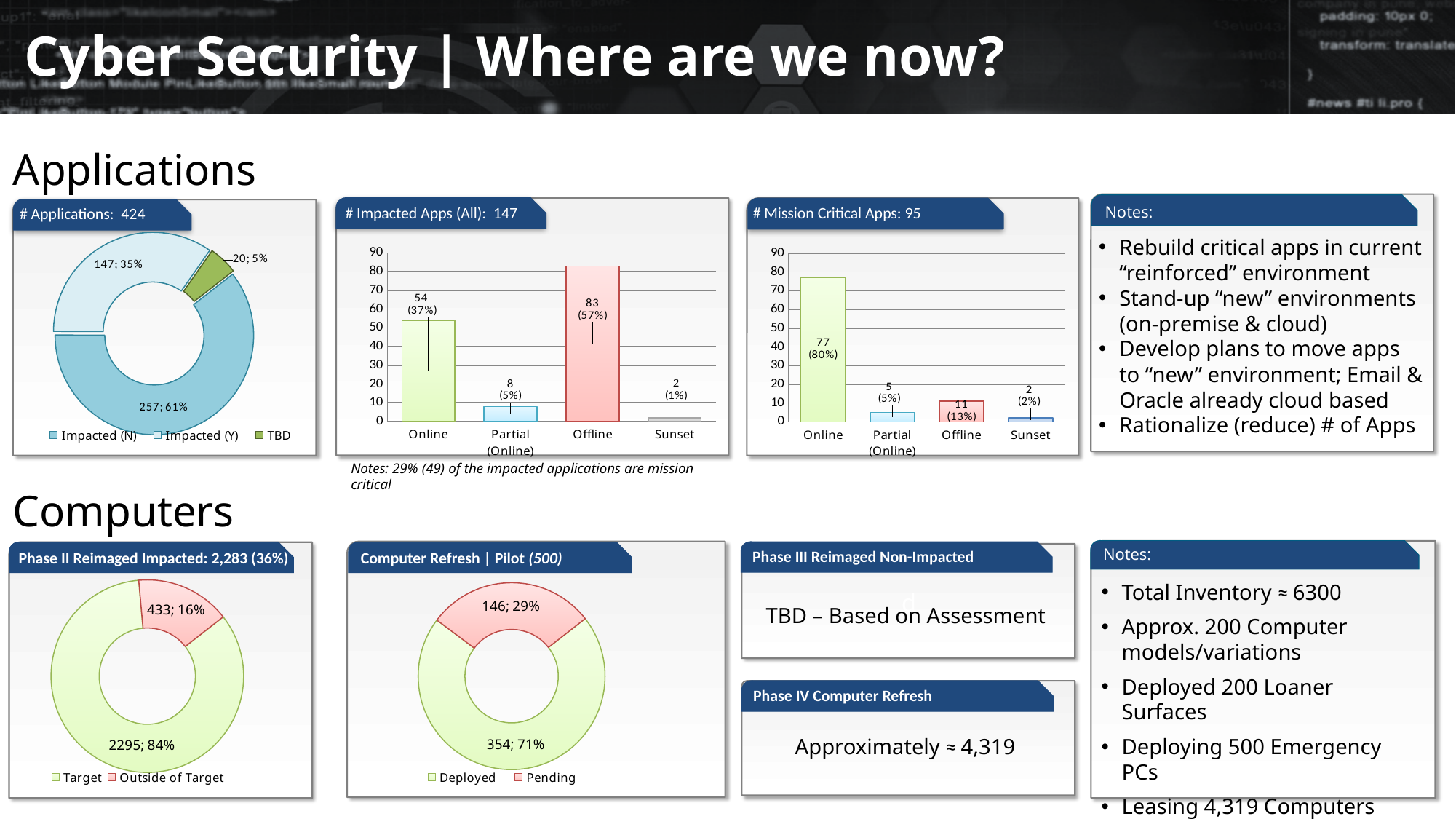
In the '# Mission Critical Apps: 95' chart, is the value for Online greater or less than 70? greater In the 'Phase II Reimaged Impacted' chart, what is the value for Outside of Target? 433; 16% How many entries does the legend of the '# Applications: 424' chart list? 3 What kind of chart is the '# Applications: 424' chart? Donut (pie) chart In the '# Applications: 424' chart, what share of applications is Impacted (N)? 61% In the '# Mission Critical Apps: 95' chart, which is larger: Offline or Partial (Online)? Offline In the '# Impacted Apps (All): 147' chart, what is the value for Offline? 83 (57%) In the '# Impacted Apps (All): 147' chart, which category has the lowest value? Sunset In the '# Impacted Apps (All): 147' chart, what is the difference between the Offline and Online values? 29 In the '# Mission Critical Apps: 95' chart, which category has the highest value? Online How many categories are shown on the x axis of the '# Impacted Apps (All): 147' chart? 4 In the 'Computer Refresh | Pilot (500)' chart, what is the total of Deployed and Pending? 500